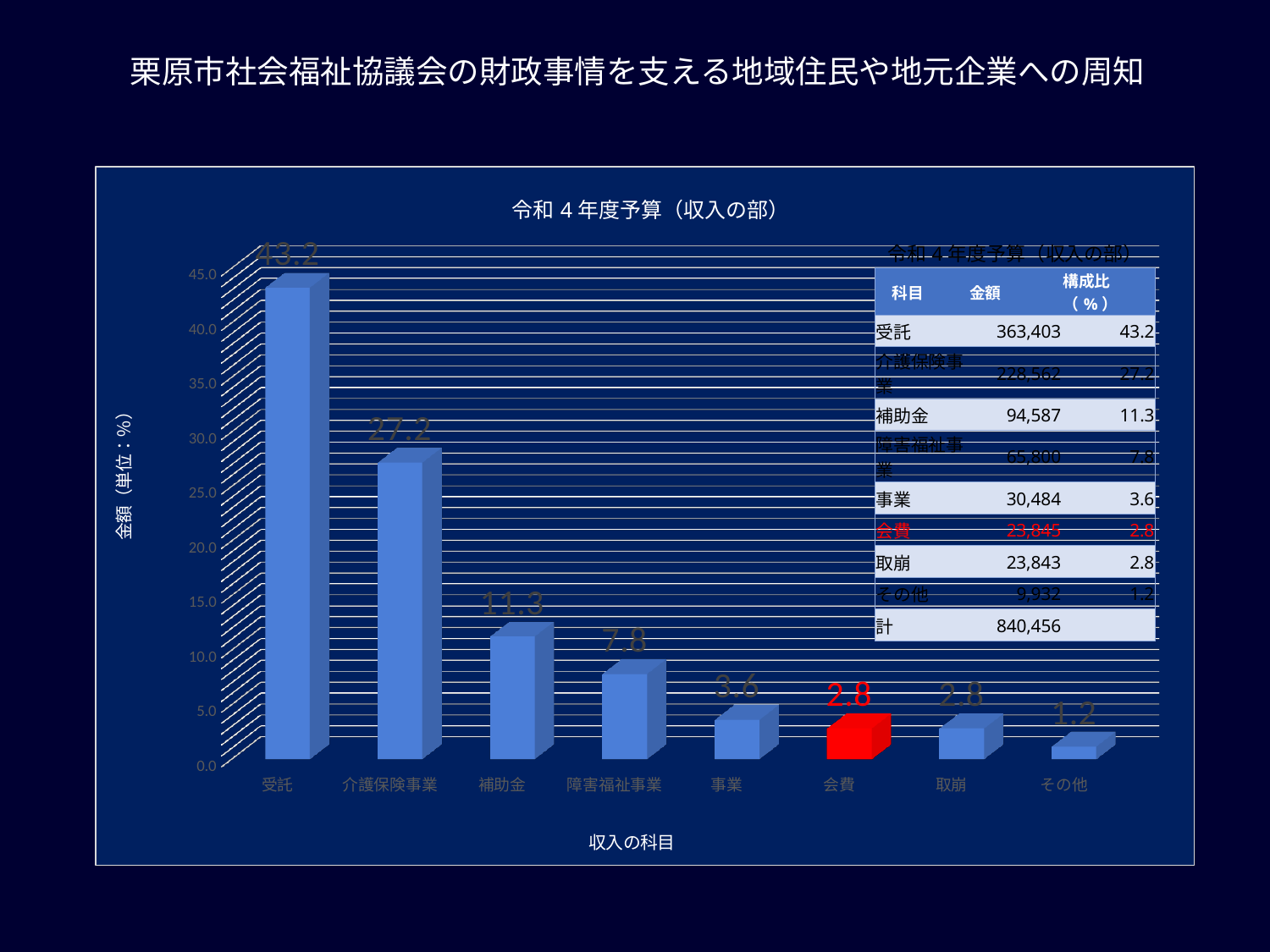
How many categories are shown on the x axis? 8 Which is larger, the value for 障害福祉事業 or the value for 事業? 障害福祉事業 What type of chart is shown on the slide? bar chart What is the label of the x axis? 収入の科目 What is the value for 会費? 2.8 Which category has the highest value? 受託 What is the title of the chart? 令和４年度予算（収入の部） Which category has the lowest value? その他 What is the difference between the values for 受託 and 介護保険事業? 16.0 What is the value for 介護保険事業? 27.2 What is the value for 受託? 43.2 What is the value for 補助金? 11.3